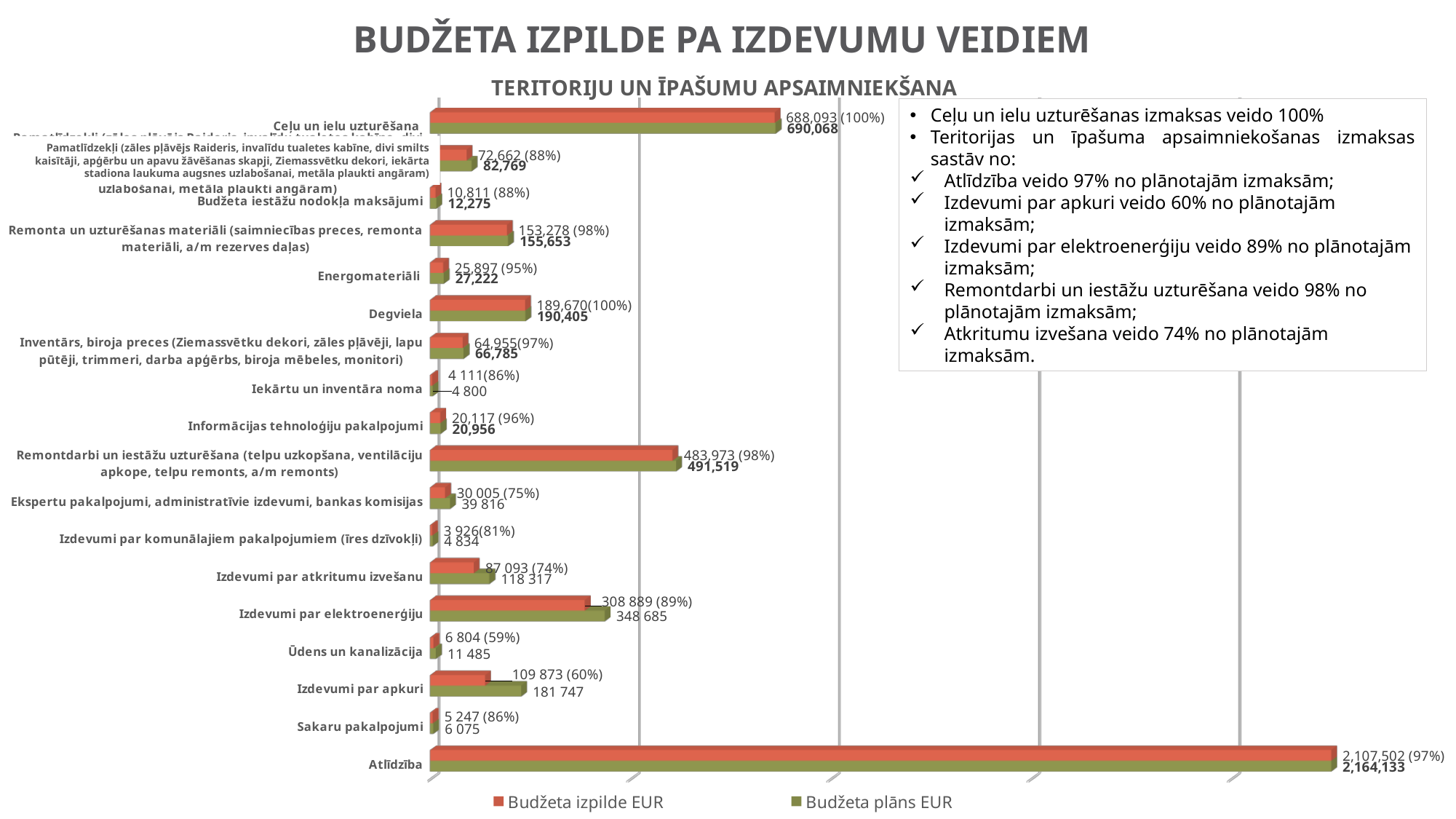
How many series does the legend list? 2 What is the Budžeta plāns EUR value for Izdevumi par elektroenerģiju? 348 685 Which category has the highest Budžeta izpilde EUR value? Atlīdzība What is the difference between the Budžeta plāns EUR and Budžeta izpilde EUR values for Izdevumi par apkuri? 71 874 Which has a larger Budžeta izpilde EUR value: Degviela or Ceļu un ielu uzturēšana? Ceļu un ielu uzturēšana What are the two series named in the chart legend? Budžeta izpilde EUR and Budžeta plāns EUR How many categories are shown on the chart? 18 What is the Budžeta izpilde EUR value for Degviela? 189,670 What is the difference between the Budžeta plāns EUR and Budžeta izpilde EUR values for Ceļu un ielu uzturēšana? 1,975 What percentage of the plan is shown next to the Budžeta izpilde bar for Izdevumi par atkritumu izvešanu? 74% What is the Budžeta plāns EUR value for Atlīdzība? 2,164,133 What kind of chart is shown on the slide? Bar chart